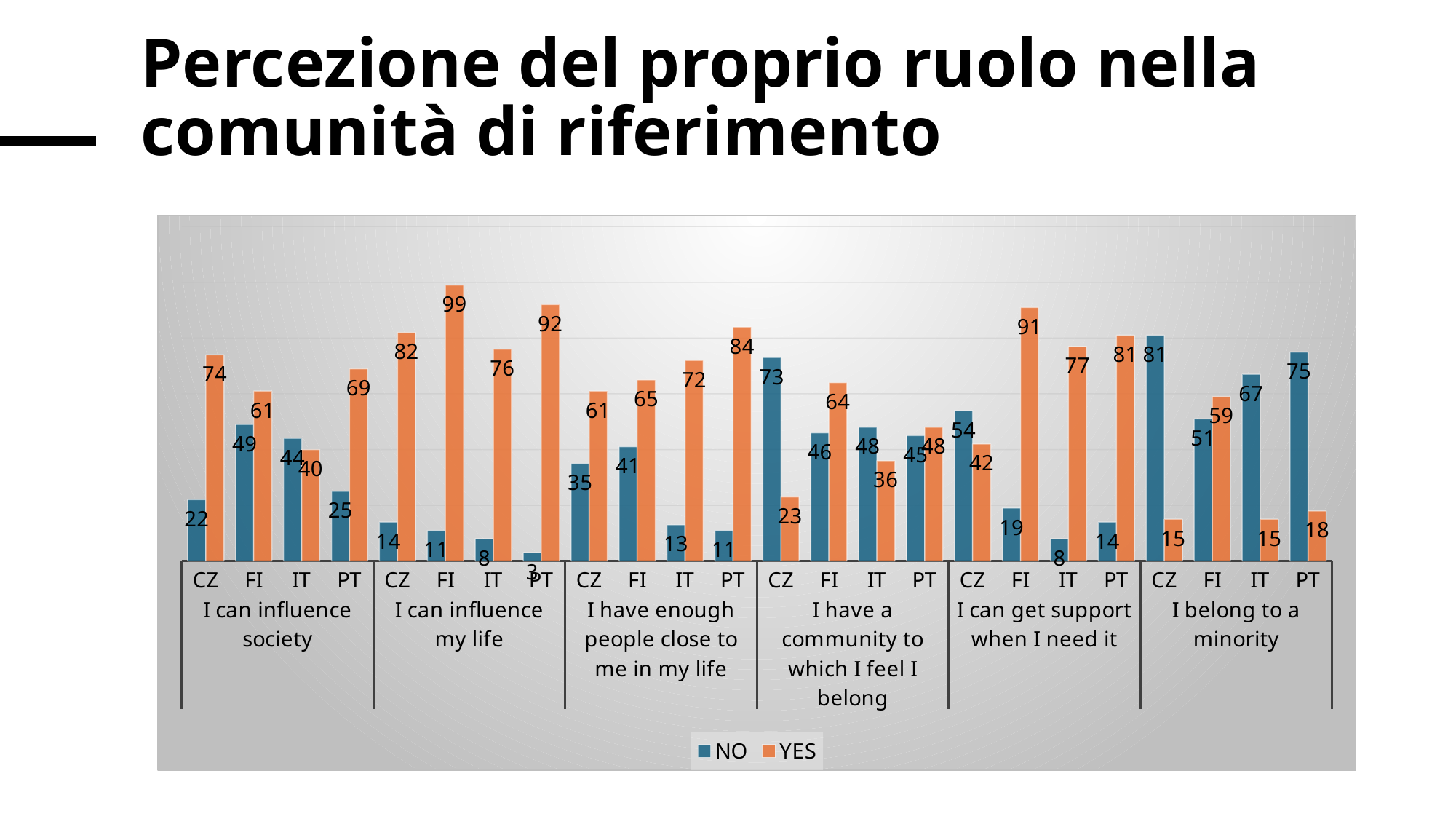
What is the YES value for FI under "I can influence my life"? 99 What is the difference between the YES and NO values for CZ under "I have a community to which I feel I belong"? 50 What is the YES value for PT under "I have enough people close to me in my life"? 84 Under "I can influence society", is the NO or the YES value larger for IT? NO How many statements (category groups) are shown on the x axis? 6 What is the NO value for CZ under "I belong to a minority"? 81 What is the NO value for PT under "I can influence my life"? 3 Which country has the lowest NO value under "I can influence society"? CZ Which country has the highest YES value under "I can get support when I need it"? FI What kind of chart is shown on the slide? Bar chart How many series does the legend list? 2 Which colour represents the YES series in the legend? Orange